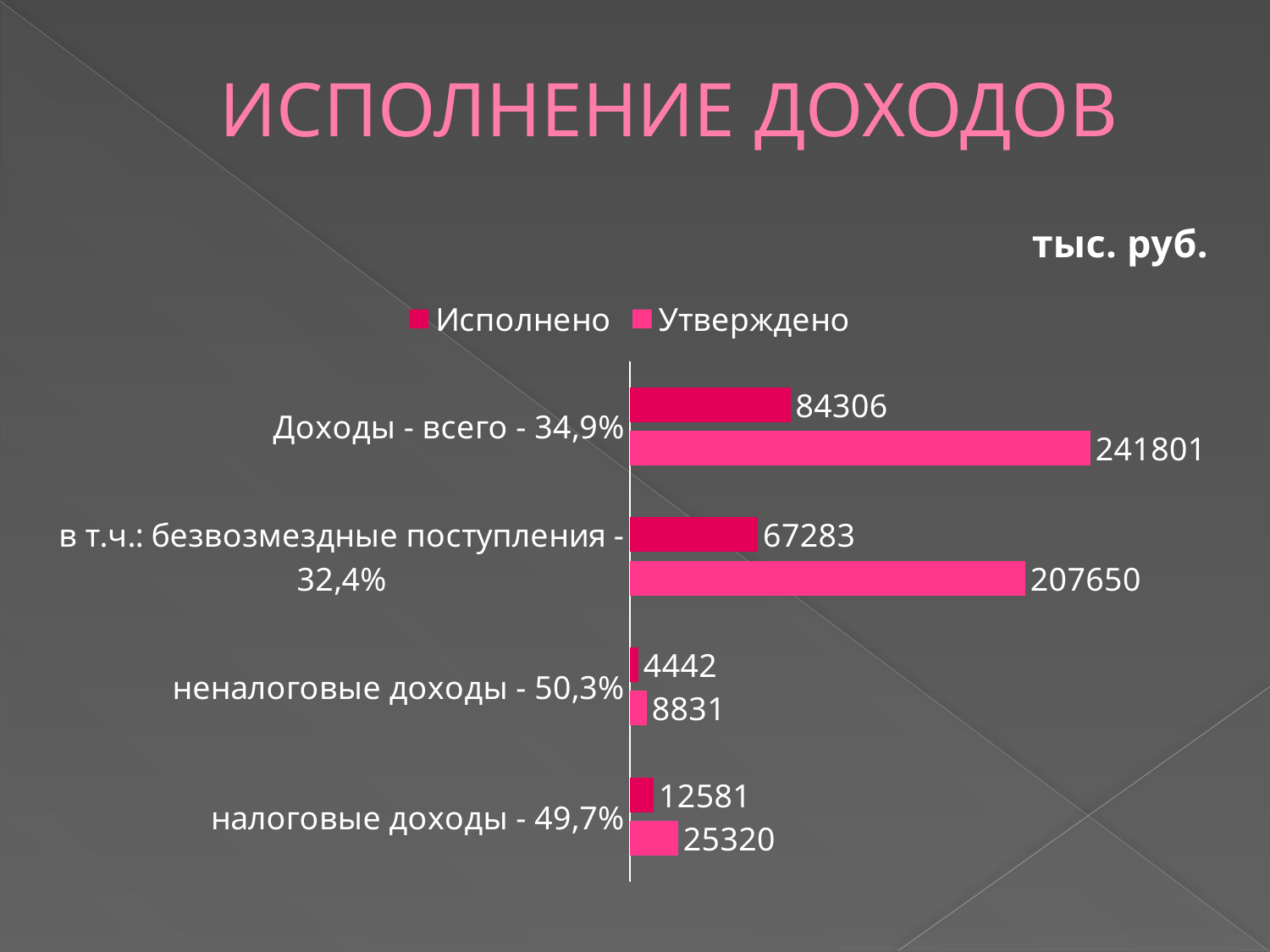
Which category has the highest Утверждено value? Доходы - всего - 34,9% What type of chart is shown on the slide? Bar chart What is the Утверждено value for "в т.ч.: безвозмездные поступления - 32,4%"? 207650 How many categories are shown in the chart? 4 What is the difference between the Утверждено and Исполнено values for "налоговые доходы - 49,7%"? 12739 How many series does the legend list? 2 What is the Утверждено value for "налоговые доходы - 49,7%"? 25320 What is the Исполнено value for "неналоговые доходы - 50,3%"? 4442 What is the Исполнено value for "Доходы - всего - 34,9%"? 84306 Which is larger: the Исполнено value for "в т.ч.: безвозмездные поступления - 32,4%" or the Утверждено value for "налоговые доходы - 49,7%"? Исполнено for в т.ч.: безвозмездные поступления - 32,4% Which category has the lowest Исполнено value? неналоговые доходы - 50,3% What is the Утверждено value for "Доходы - всего - 34,9%"? 241801